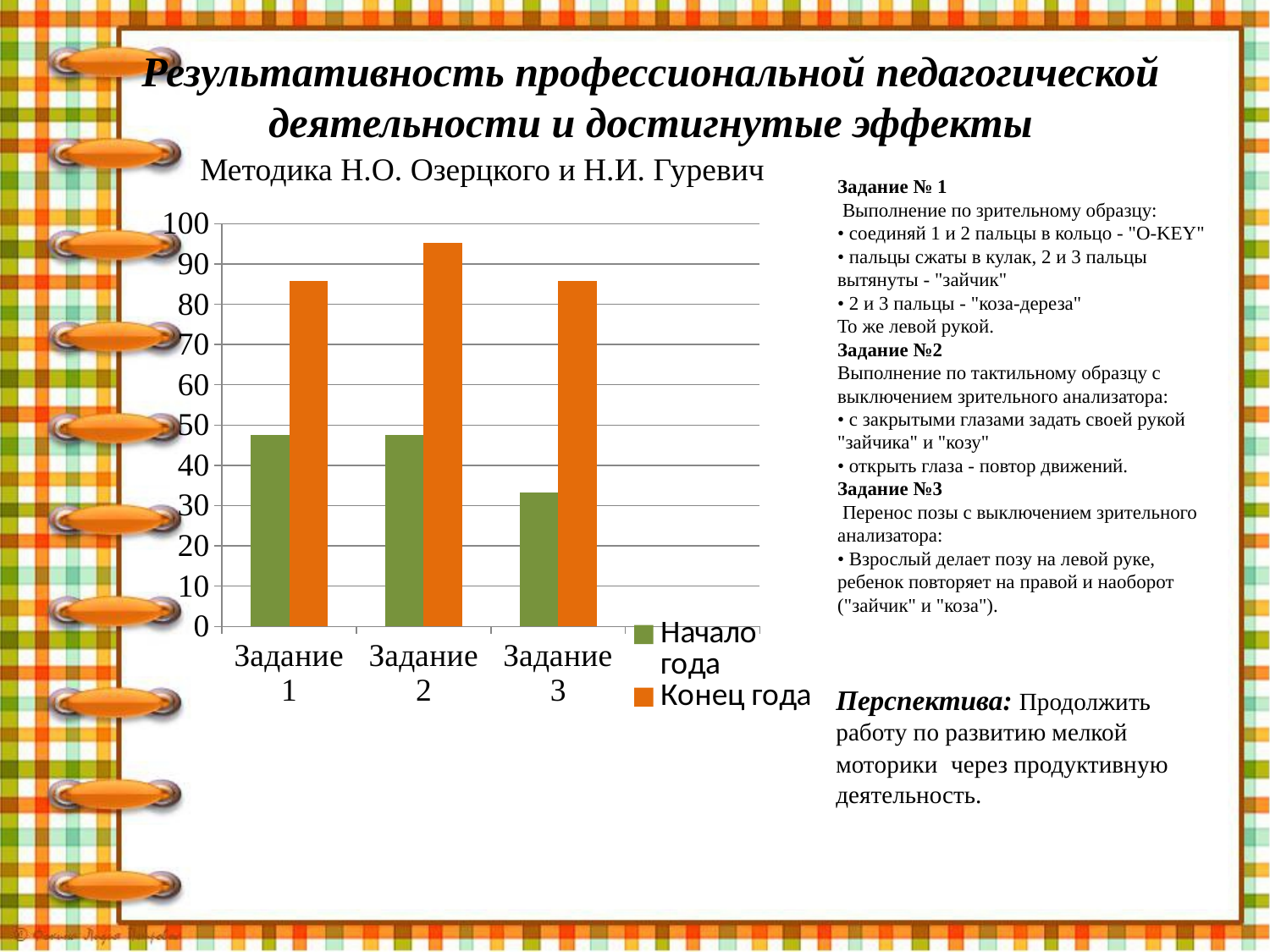
For the series 'Начало года', which category has the lowest value? Задание 3 For the series 'Конец года', which category has the highest value? Задание 2 Is the value for 'Начало года' in 'Задание 1' greater or less than 50? less How many series does the chart legend list? 2 Is the value for 'Конец года' in 'Задание 2' greater or less than 90? greater What kind of chart is shown on the slide? bar chart What are the two series named in the chart legend? Начало года, Конец года Which colour represents the series 'Конец года' in the chart? orange How many categories are shown on the x axis of the chart? 3 Is the value for 'Конец года' in 'Задание 3' greater or less than 80? greater For 'Задание 1', which series has the larger value, 'Начало года' or 'Конец года'? Конец года